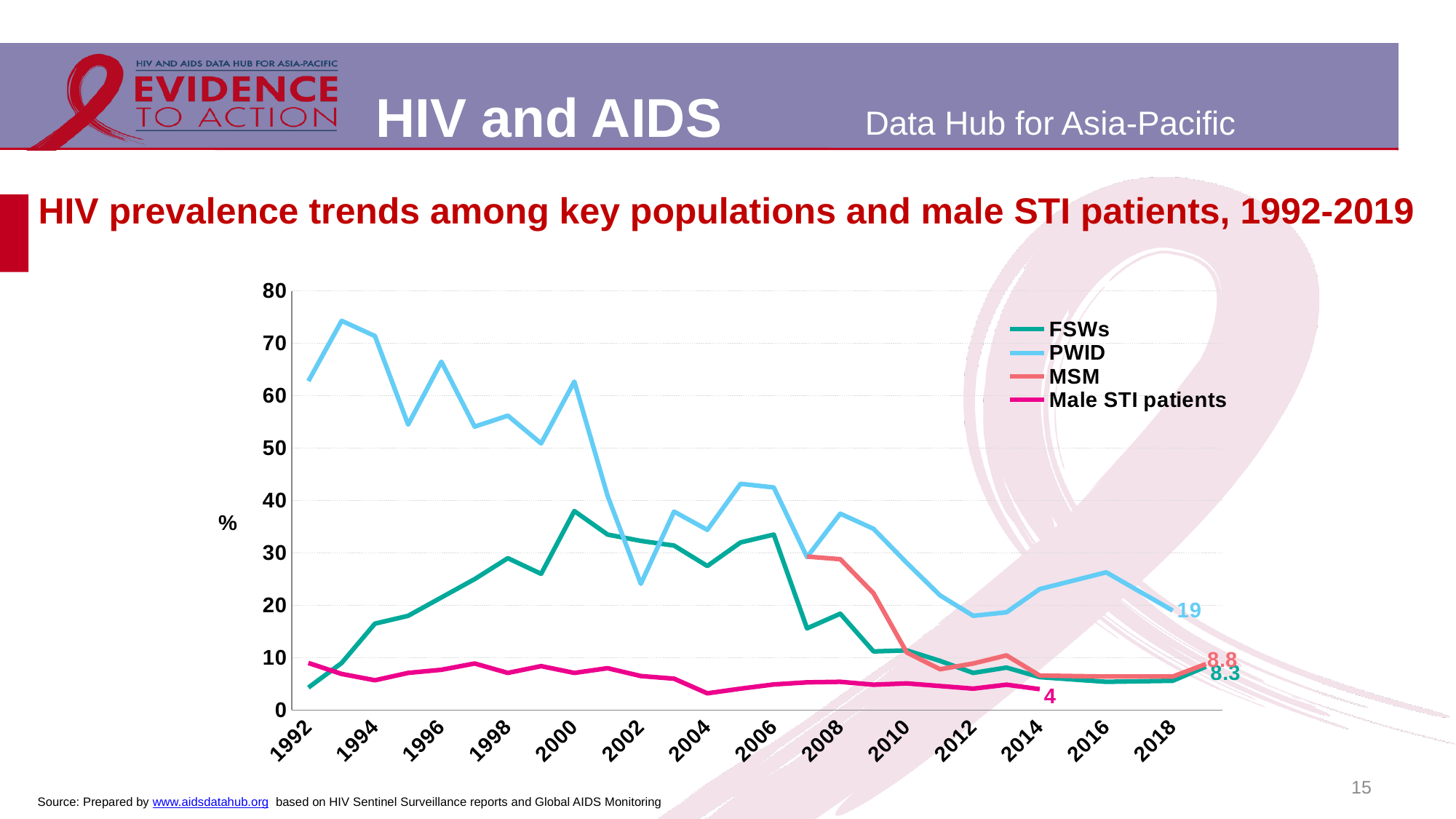
Which series has the higher labelled value in 2019, PWID or MSM? PWID Does the PWID line overall rise or fall from 1992 to 2019? fall What is the labelled value at the last point of the Male STI patients line? 4 What kind of chart is shown on the slide? line chart How many series does the legend list? 4 Which series has the highest value at the end of the chart in 2019? PWID What is the label on the vertical axis of the chart? % What is the labelled value for FSWs at the end of the series in 2019? 8.3 What is the labelled value for MSM at the end of the series in 2019? 8.8 What is the difference between the labelled 2019 values for MSM and FSWs? 0.5 Is the value for PWID in 1992 greater or less than 50? greater